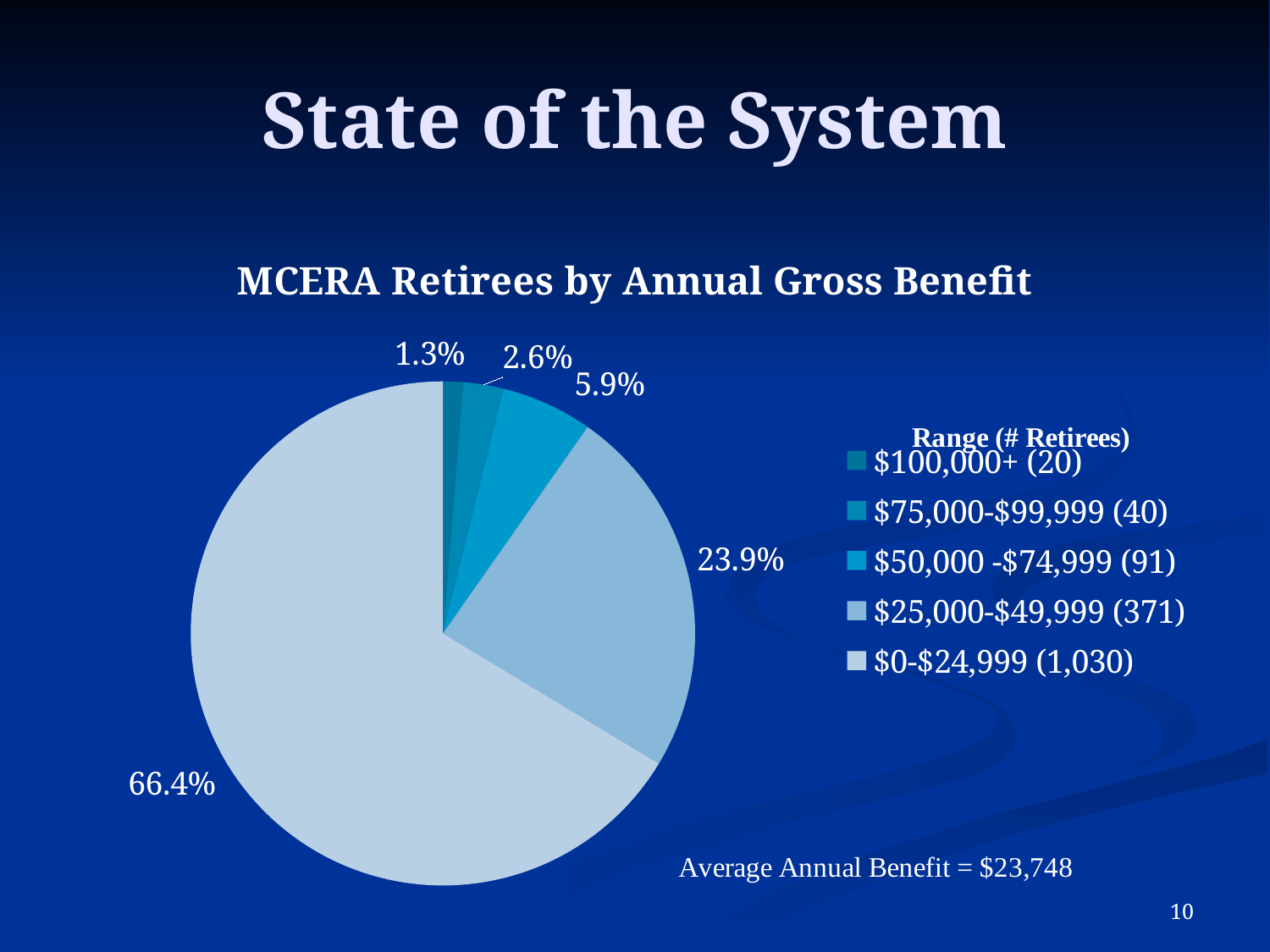
What is the title of the chart? MCERA Retirees by Annual Gross Benefit What type of chart is shown on the slide? Pie chart Which benefit range has the smallest share of retirees? $100,000+ What share of the pie does the $0-$24,999 range represent? 66.4% How many slices does the pie chart have? 5 What share of the pie does the $50,000-$74,999 range represent? 5.9% Which slice is larger: $75,000-$99,999 or $50,000-$74,999? $50,000-$74,999 How many retirees are in the $25,000-$49,999 range according to the legend? 371 Which benefit range has the largest share of retirees? $0-$24,999 What share of the pie does the $25,000-$49,999 range represent? 23.9% What is the difference in percentage points between the $0-$24,999 slice and the $25,000-$49,999 slice? 42.5%